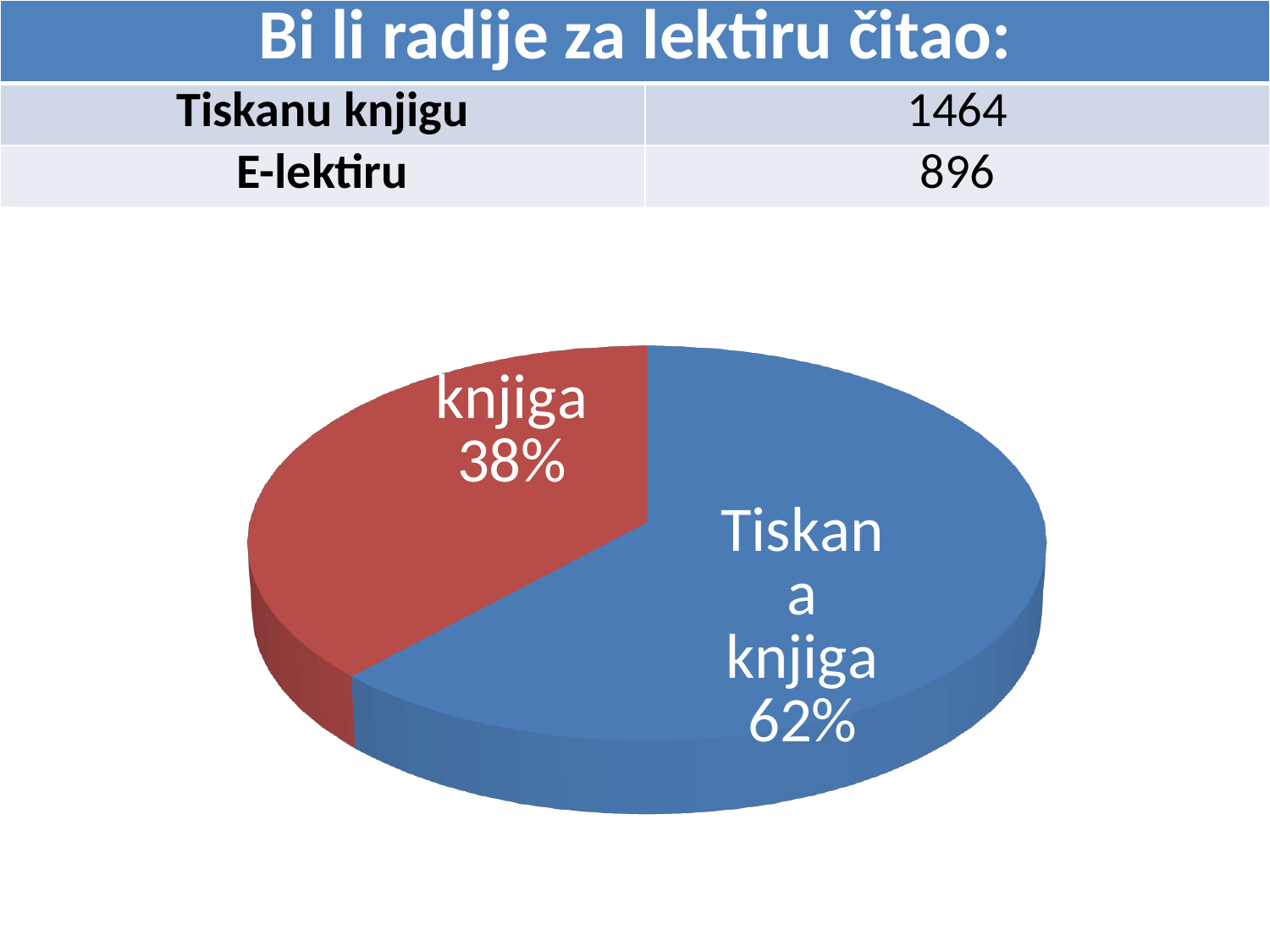
What share of the pie does the "Tiskana knjiga" slice represent? 62% Which is larger: the blue slice or the red slice of the pie chart? the blue slice What percentage is shown on the red slice of the pie chart? 38% Is the share of the "Tiskana knjiga" slice greater or less than 50%? greater Which slice of the pie chart is the largest? Tiskana knjiga How many slices does the pie chart have? 2 What kind of chart is shown on the slide? pie chart What is the difference in percentage points between the "Tiskana knjiga" slice and the red slice? 24 What is the title shown at the top of the slide above the chart? Bi li radije za lektiru čitao: What colour is the "Tiskana knjiga" slice in the pie chart? blue